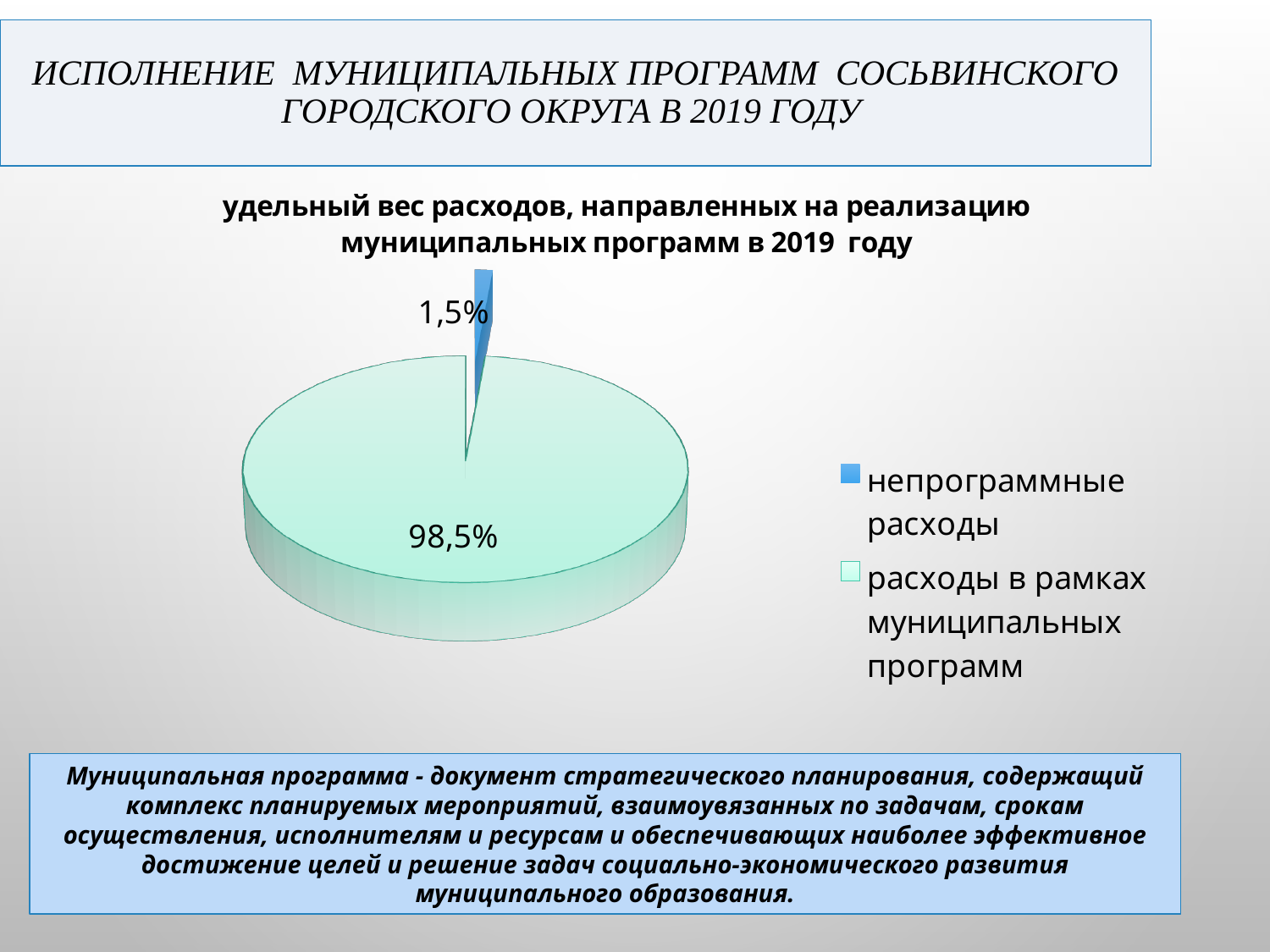
What share of the pie is labelled for расходы в рамках муниципальных программ? 98,5% Which is larger: непрограммные расходы or расходы в рамках муниципальных программ? расходы в рамках муниципальных программ What is the title of the chart? удельный вес расходов, направленных на реализацию муниципальных программ в 2019 году Which category has the largest slice of the pie? расходы в рамках муниципальных программ What is the difference in percentage points between расходы в рамках муниципальных программ and непрограммные расходы? 97 percentage points How many entries does the legend list? 2 Which category has the smallest slice of the pie? непрограммные расходы What colour is the slice for непрограммные расходы? blue How many slices does the pie chart have? 2 What kind of chart is shown on the slide? pie chart What share of the pie is labelled for непрограммные расходы? 1,5%